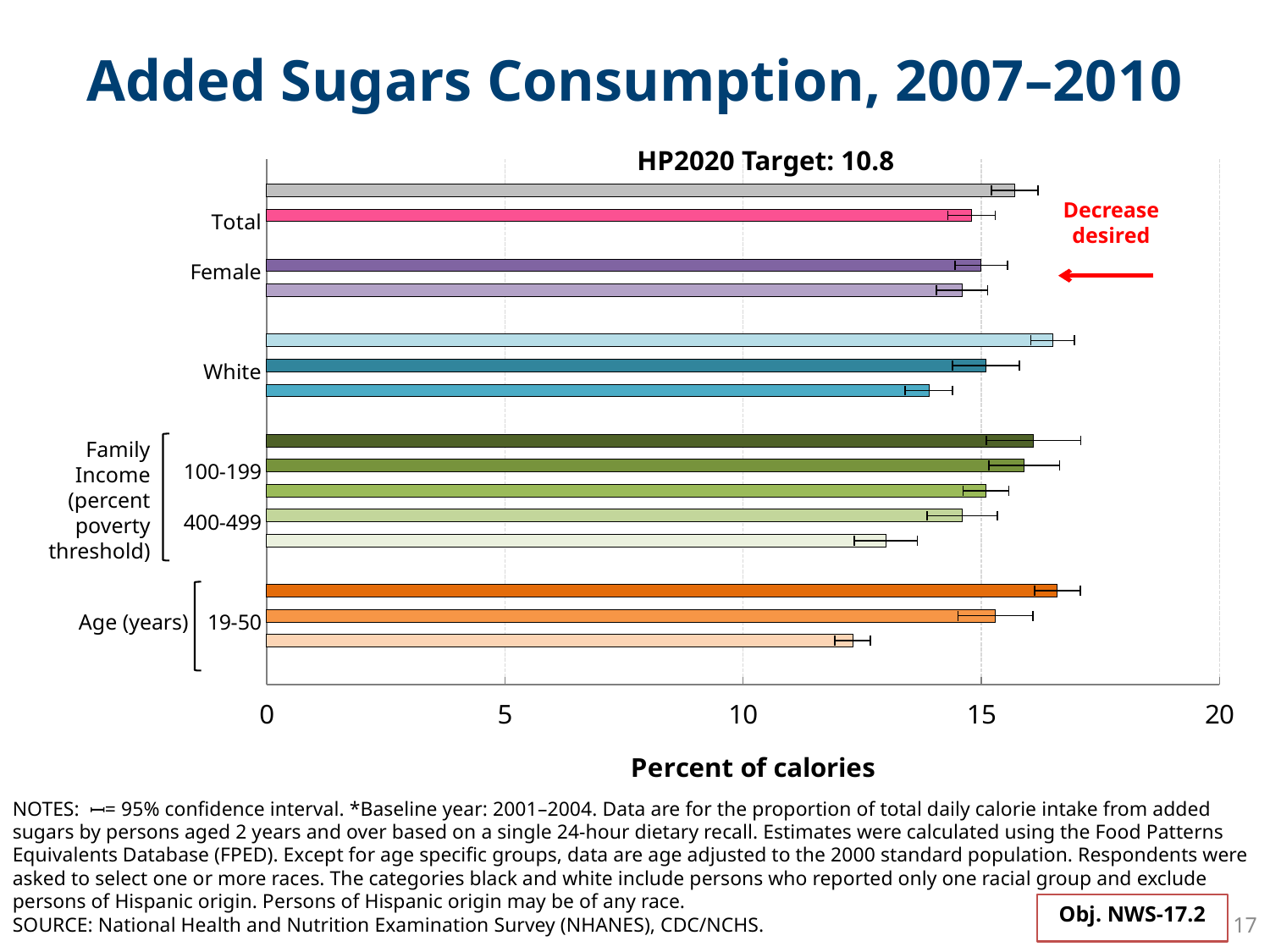
Is the value for Female greater or less than 10? greater Is the value for the 400-499 family income group greater or less than 15? less Is the value for Total greater or less than 10? greater Which has the larger value, Total or the 100-199 family income group? 100-199 What is the label of the x axis? Percent of calories What kind of chart is shown on the slide? bar chart What is the HP2020 Target value shown on the chart? 10.8 Which has the larger value, the 100-199 family income group or the 400-499 family income group? 100-199